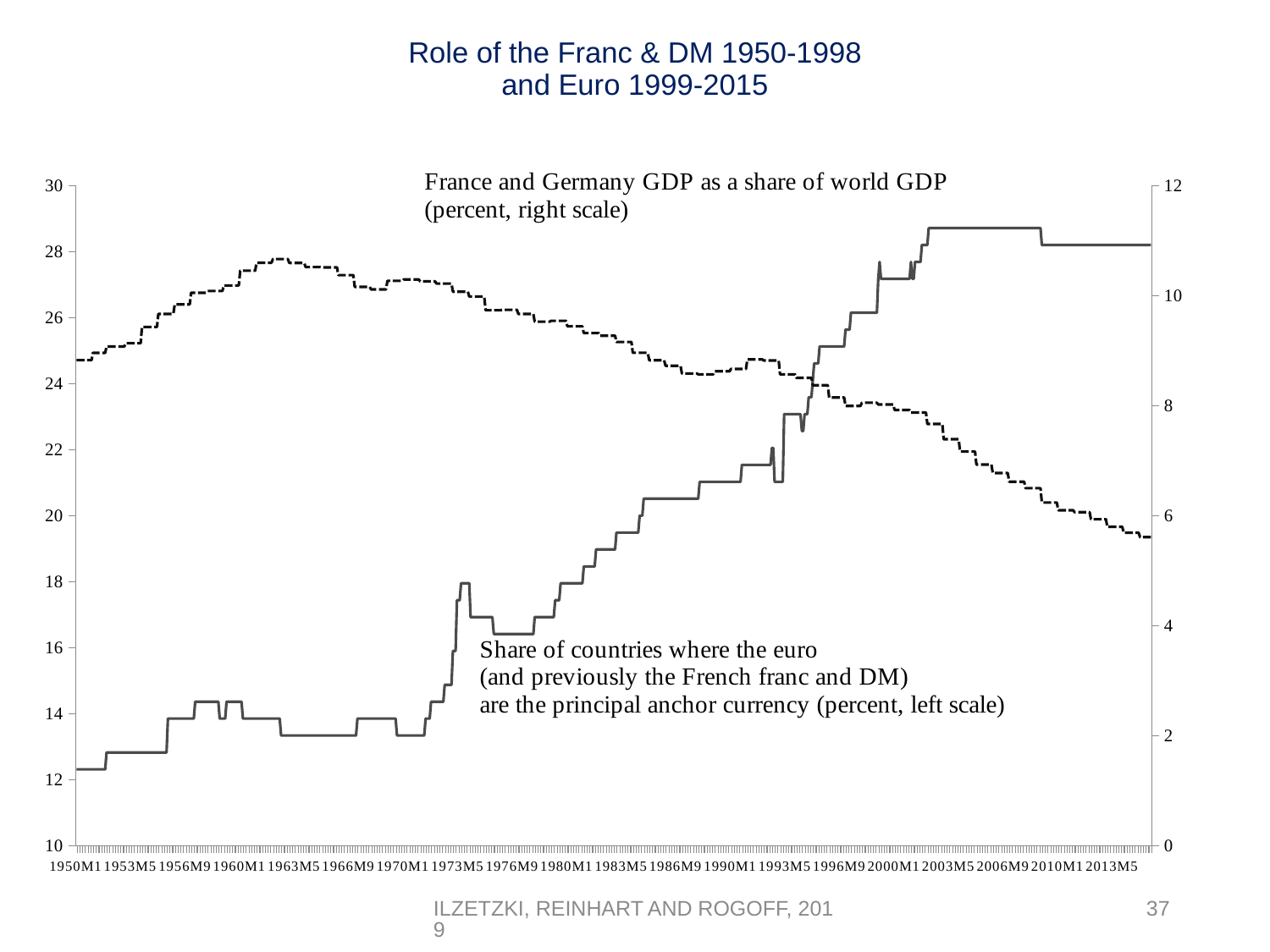
Does the share of countries where the euro (and previously the French franc and DM) are the principal anchor currency rise or fall overall from 1950M1 to 2013M5? rise Is the peak value of the France and Germany GDP share of world GDP greater or less than 10 on the right scale? greater Does the France and Germany GDP share of world GDP rise or fall from the early 1960s to 2013M5? fall Is the share of countries with the franc/DM as principal anchor currency at 1950M1 greater or less than 14 on the left scale? less Is the share of countries with the euro as principal anchor currency at 2013M5 greater or less than the share at 1950M1? greater Is the France and Germany GDP share of world GDP at 2013M5 greater or less than 6 on the right scale? less Which series is plotted against the right scale? France and Germany GDP as a share of world GDP What is the title of the slide? Role of the Franc & DM 1950-1998 and Euro 1999-2015 How many data series are plotted on the chart? 2 What kind of chart is shown on the slide? line chart